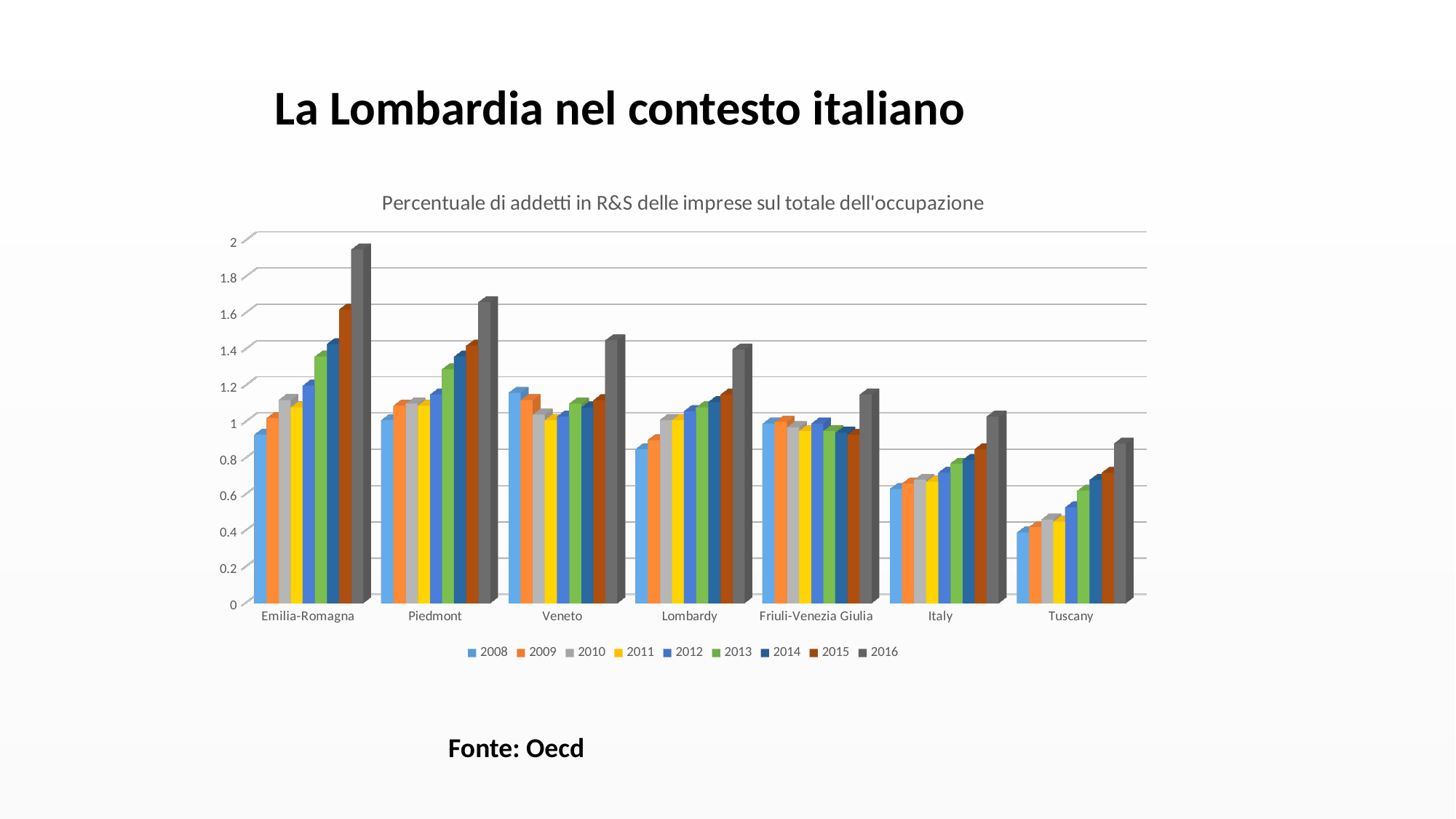
How many series (years) does the legend list? 9 Is the 2016 value for Emilia-Romagna greater or less than 1.8? greater For Emilia-Romagna, do the values generally rise or fall from 2008 to 2016? rise What is the title of the chart? Percentuale di addetti in R&S delle imprese sul totale dell'occupazione Which is larger, the 2008 value for Veneto or the 2008 value for Lombardy? Veneto Which category has the lowest bar in the chart? Tuscany What kind of chart is shown on the slide? bar chart How many regions/categories are shown on the x axis of the chart? 7 Which category has the highest bar in the chart? Emilia-Romagna Is the 2008 value for Tuscany greater or less than 0.6? less Is the 2016 value for Piedmont greater or less than 1.4? greater Which is larger, the 2016 value for Emilia-Romagna or the 2016 value for Piedmont? Emilia-Romagna